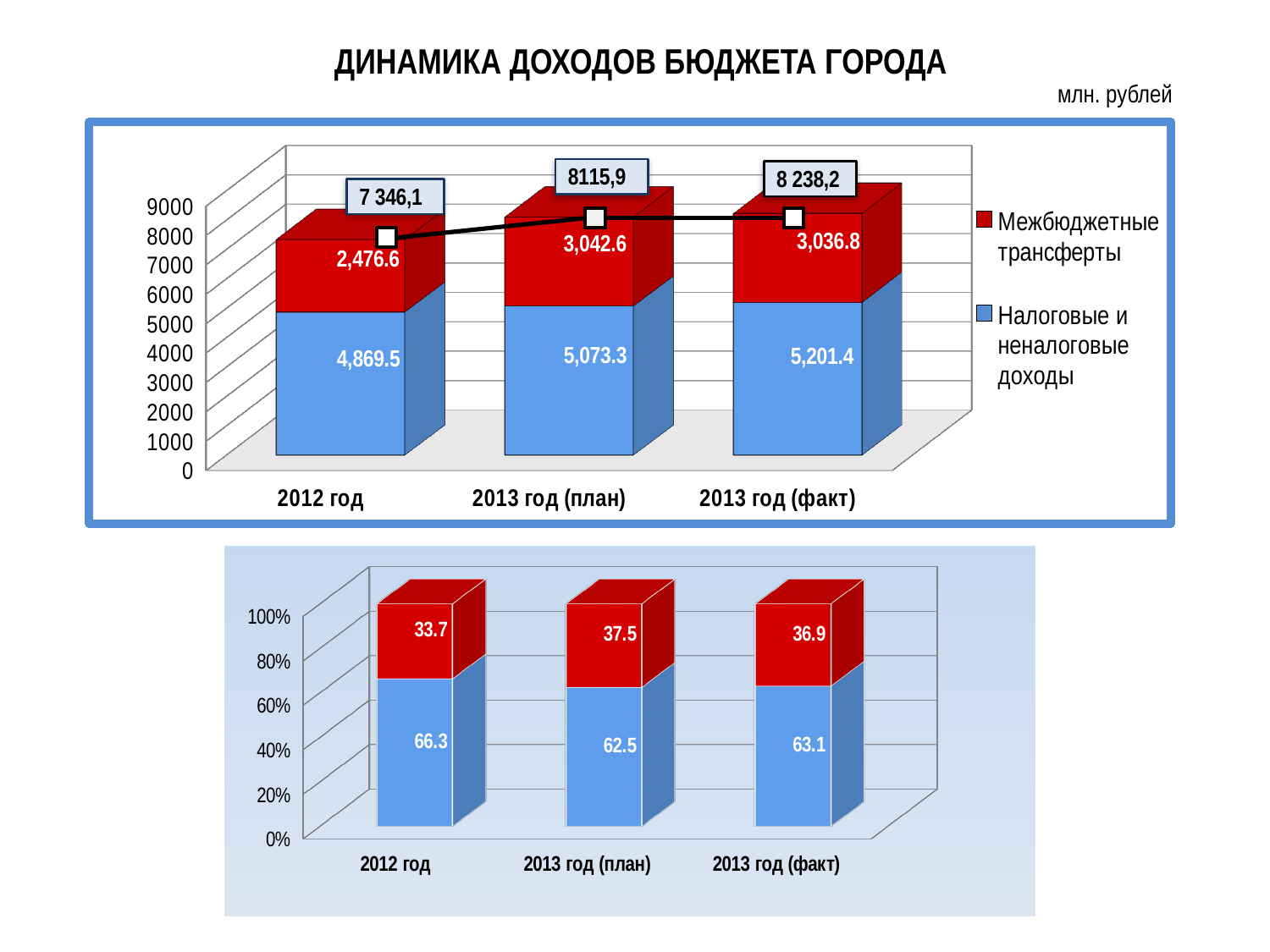
In the bottom chart, what is the difference between the red segment values for 2013 год (план) and 2012 год? 3.8 In the top chart, what total is labelled above the bar for 2013 год (факт)? 8 238,2 What kind of chart is the top chart? Stacked bar chart In the top chart, which is larger for Межбюджетные трансферты: 2013 год (план) or 2013 год (факт)? 2013 год (план) How many series does the legend of the top chart list? 2 In the bottom chart, what percentage is shown for the red segment of 2013 год (план)? 37.5 In the top chart, which category has the highest value for Налоговые и неналоговые доходы? 2013 год (факт) In the top chart, by how much does Налоговые и неналоговые доходы for 2013 год (факт) exceed that for 2012 год? 331.9 How many categories are shown on the x axis of the top chart? 3 In the top chart, which category has the lowest value for Межбюджетные трансферты? 2012 год In the top chart, what is the value of Налоговые и неналоговые доходы for 2012 год? 4,869.5 In the top chart, what is the value of Межбюджетные трансферты for 2013 год (план)? 3,042.6